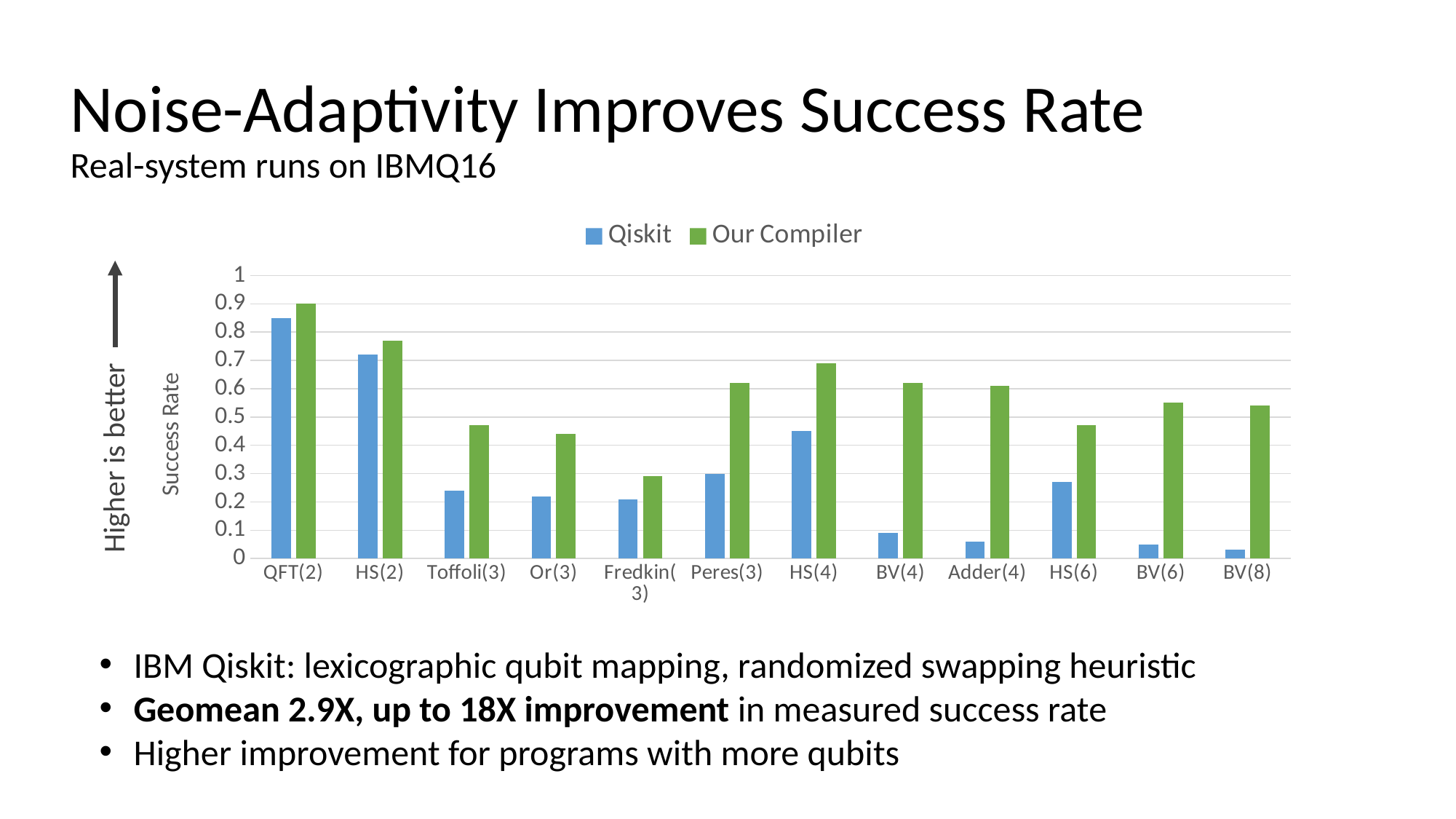
What kind of chart is shown on the slide? bar chart Is the Qiskit value for Toffoli(3) greater or less than 0.3? less Is the Qiskit value for BV(8) greater or less than 0.1? less Is the Our Compiler value for HS(4) greater or less than 0.6? greater Which category has the highest Our Compiler success rate? QFT(2) Do the Qiskit success rates generally rise or fall from left to right along the x axis? fall How many series does the legend list? 2 Which category has the lowest Qiskit success rate? BV(8) For HS(4), which series has the larger success rate, Qiskit or Our Compiler? Our Compiler What is the label of the y axis? Success Rate How many benchmark categories are shown on the x axis? 12